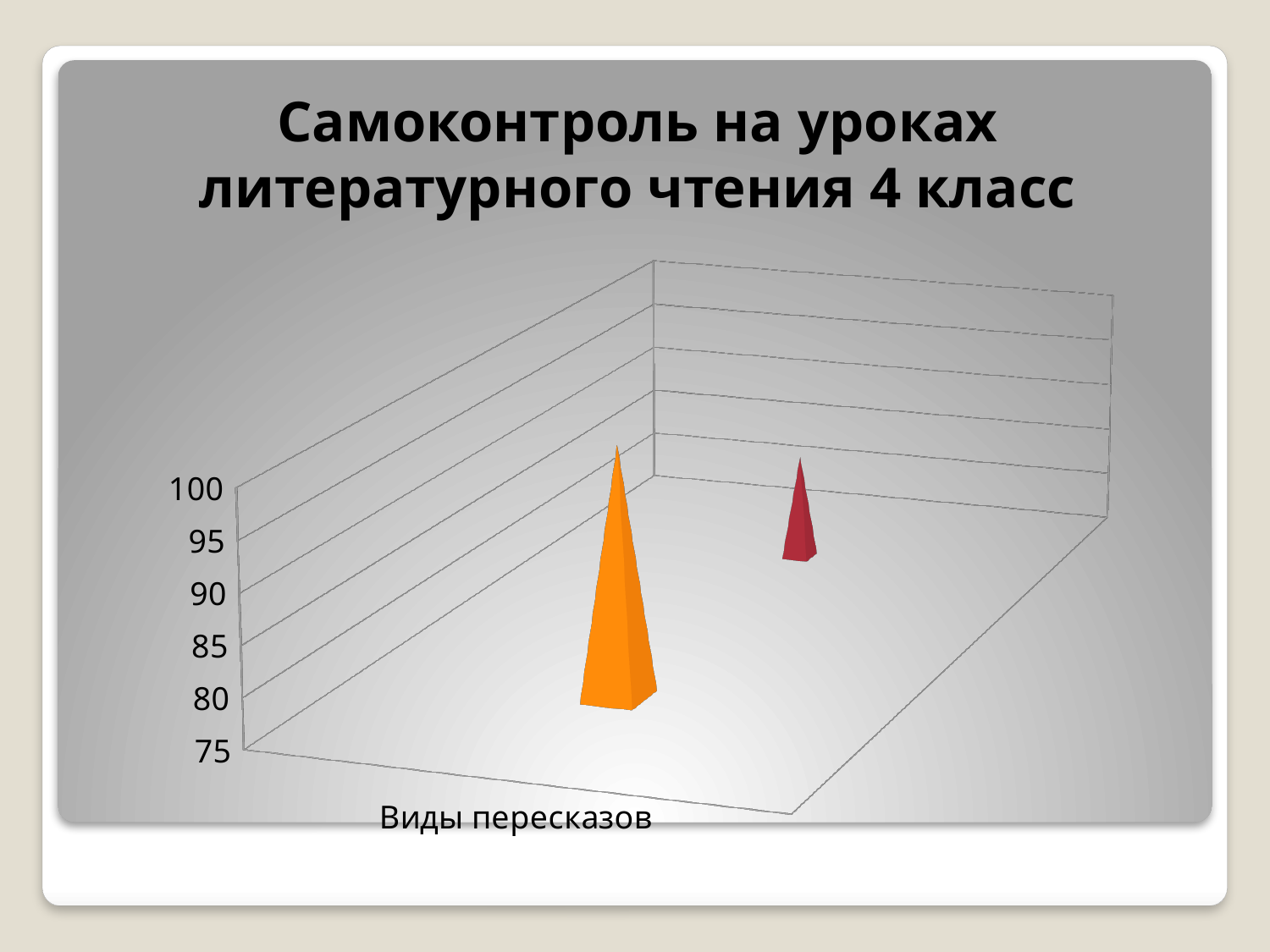
What is the lowest value labelled on the vertical axis? 75 What is the step between consecutive tick labels on the vertical axis? 5 What is the title shown above the chart? Самоконтроль на уроках литературного чтения 4 класс What is the title of the chart's horizontal axis? Виды пересказов How many tick labels are shown on the vertical axis? 6 Which bar is taller, the orange one or the red one? the orange one What kind of chart is shown on the slide? bar chart What is the highest value labelled on the vertical axis? 100 How many bars are plotted in the chart? 2